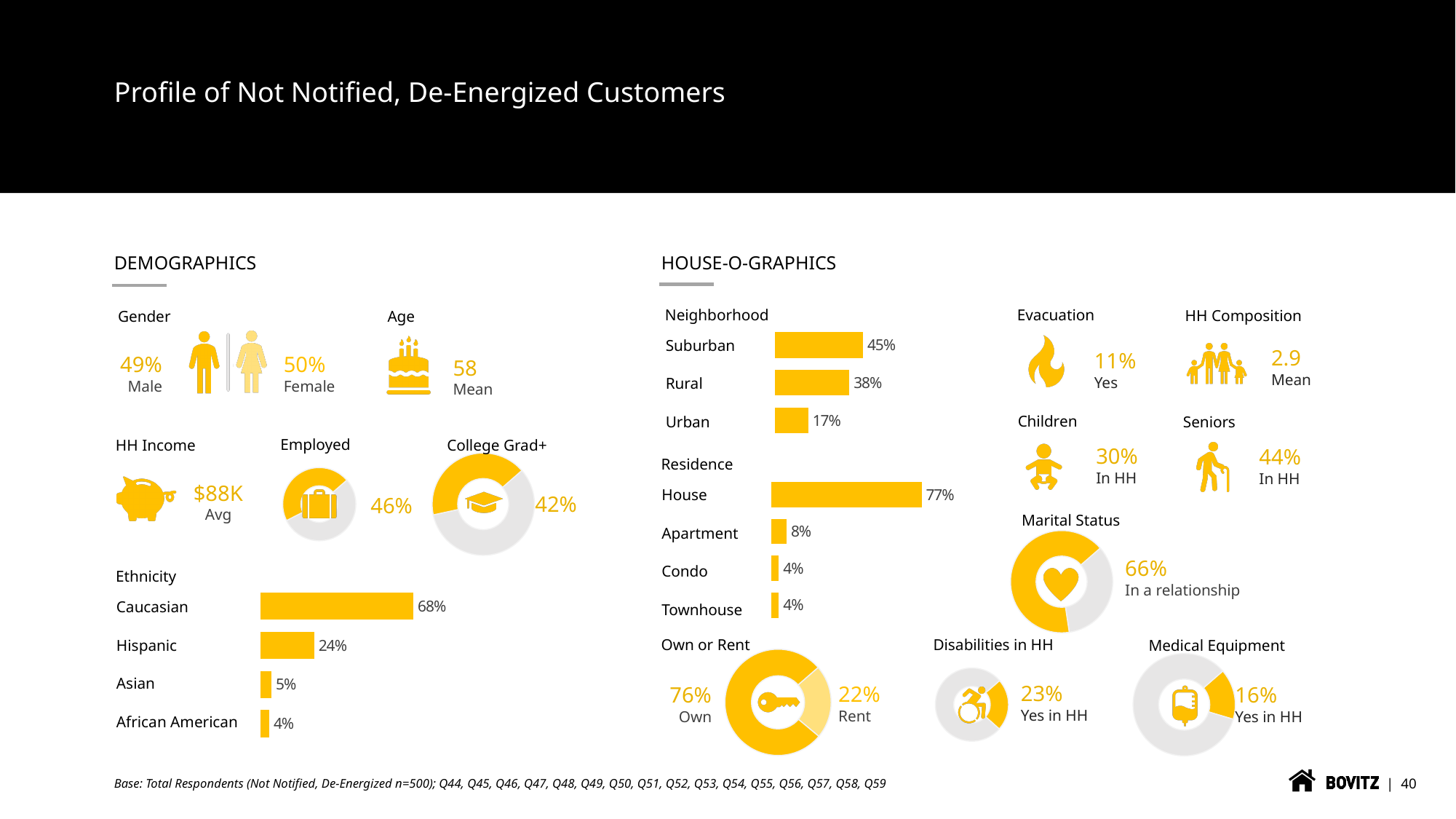
In the Neighborhood bar chart, which category has the highest value? Suburban In the Residence bar chart, which is larger, Apartment or Condo? Apartment How many categories does the Residence bar chart show? 4 What type of chart is used for Marital Status? Donut chart In the Neighborhood bar chart, what is the value for Rural? 38% How many categories does the Ethnicity bar chart show? 4 In the Ethnicity bar chart, what is the value for Caucasian? 68% In the Ethnicity bar chart, what is the difference between Caucasian and Hispanic? 44% In the Medical Equipment donut chart, what percentage answered Yes in HH? 16% In the Own or Rent donut chart, what share of respondents rent? 22% In the Residence bar chart, what is the value for House? 77% In the Ethnicity bar chart, which category has the lowest value? African American